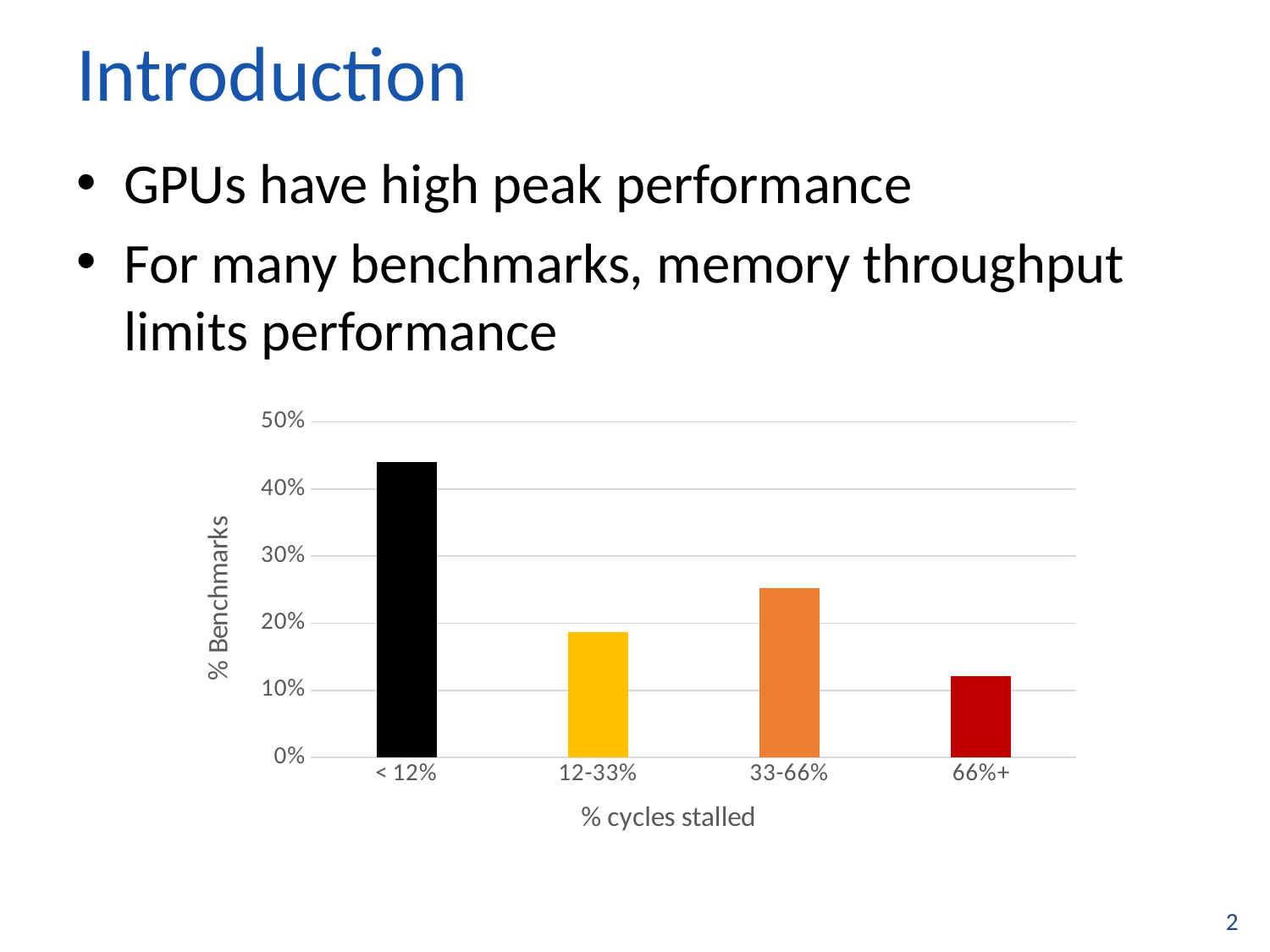
Is the value for 66%+ greater or less than 20%? less What is the title of the y axis of the chart? % Benchmarks Which category has the highest % Benchmarks? < 12% How many categories are shown on the x axis of the chart? 4 Is the value for 33-66% greater or less than 20%? greater Does the value rise or fall from the < 12% category to the 12-33% category? fall Is the value for < 12% greater or less than 40%? greater Which category has the lowest % Benchmarks? 66%+ What is the title of the x axis of the chart? % cycles stalled What kind of chart is shown on the slide? bar chart Which is larger, the value for 33-66% or the value for 12-33%? 33-66%